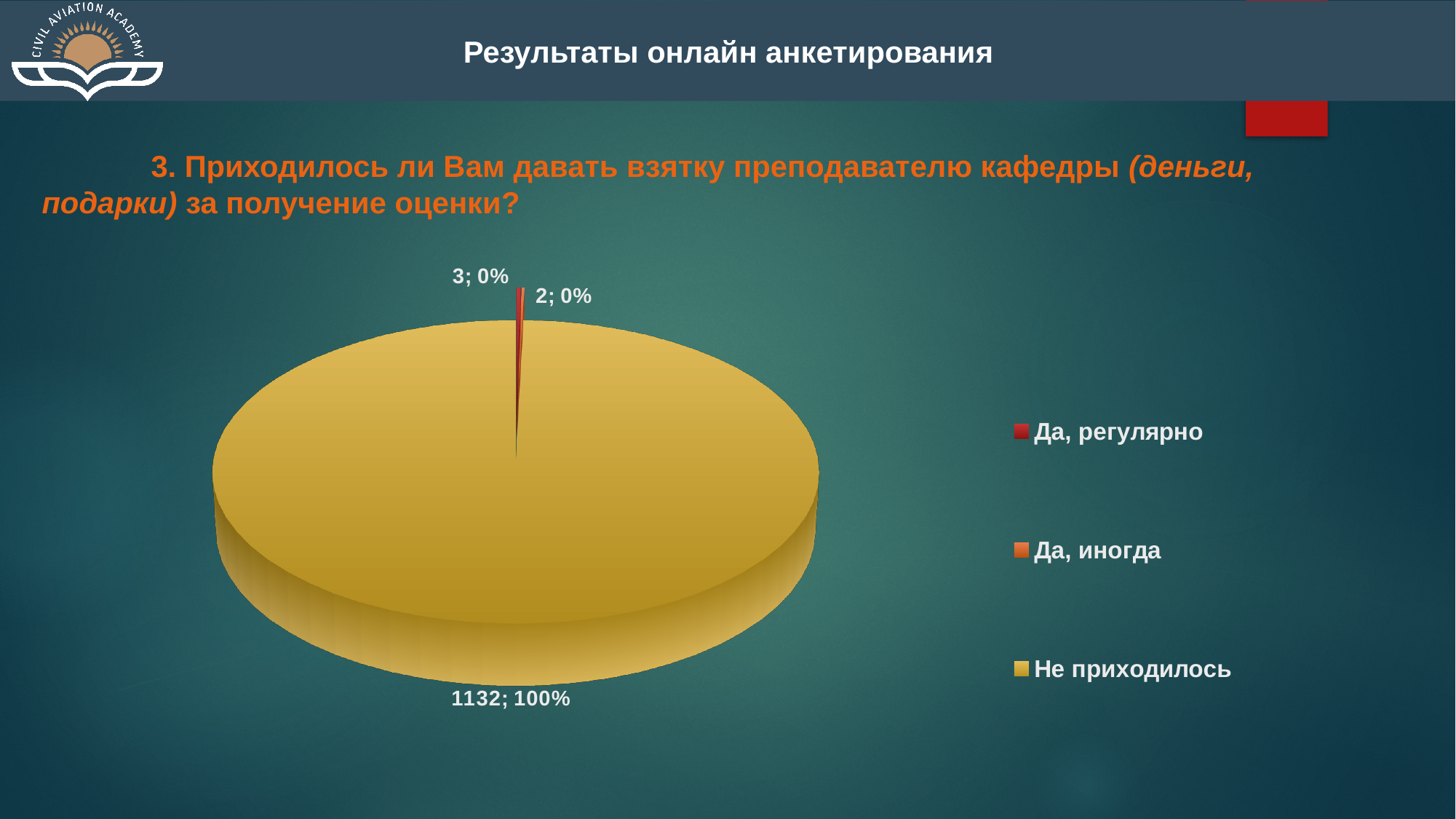
Which category has the largest slice in the pie chart? Не приходилось How many entries does the legend of the pie chart list? 3 Which is larger: the value for "Не приходилось" or the value for "Да, иногда"? Не приходилось How many slices does the pie chart have? 3 What is the total of all values shown on the pie chart? 1137 What type of chart is shown on the slide? pie chart What value is shown for the "Не приходилось" slice? 1132 What percentage share is shown for the "Не приходилось" slice? 100% Which legend entry is listed first in the pie chart's legend? Да, регулярно What colour represents "Не приходилось" in the legend? yellow What is the difference between the value of the largest slice and the combined value of the two small slices? 1127